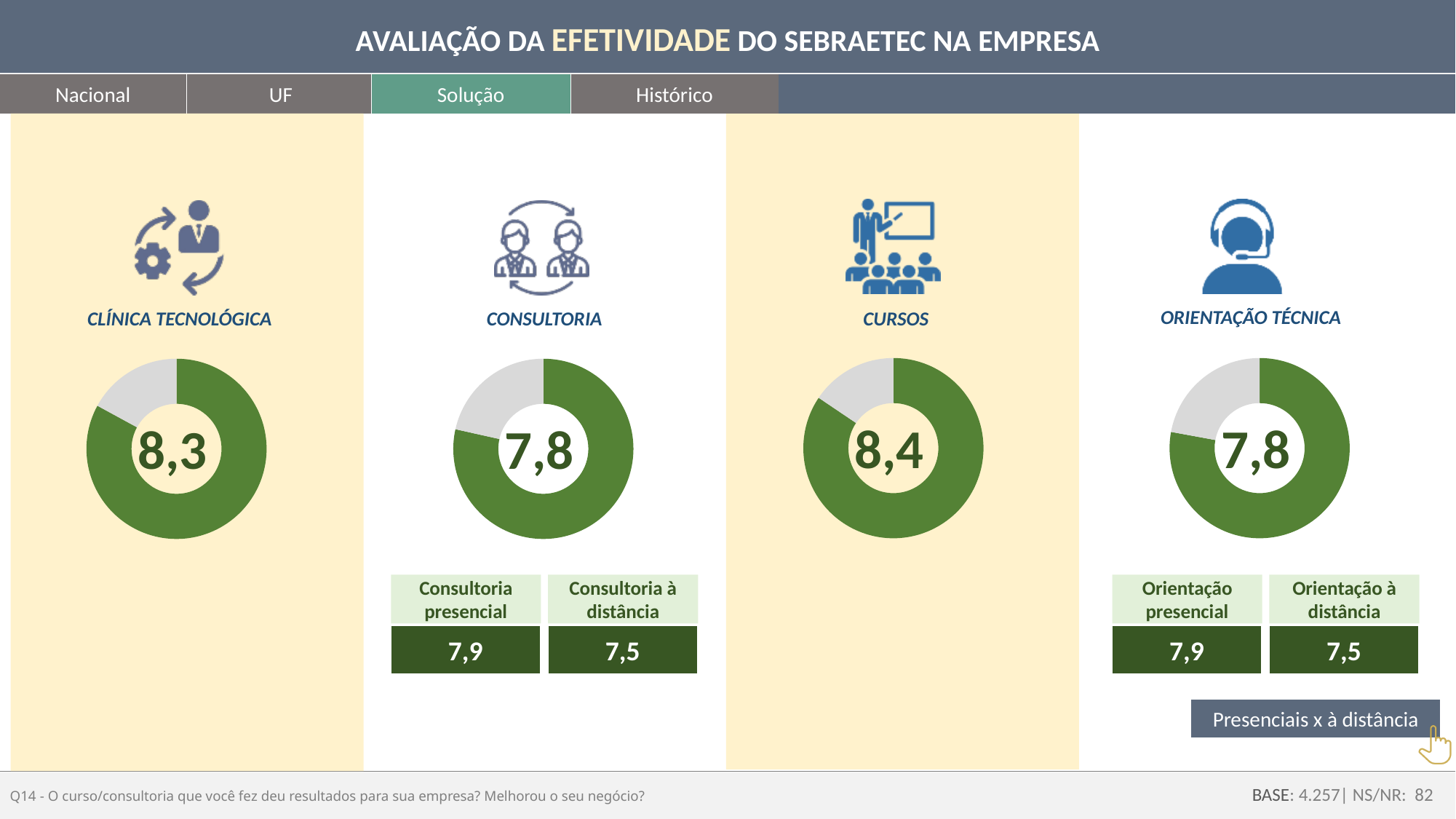
How many donut charts are shown on the slide? 4 What value is shown in the centre of the Clínica Tecnológica donut chart? 8,3 Below the Orientação Técnica chart, what value is shown for Orientação à distância? 7,5 What is the difference between the Cursos value and the Consultoria value? 0,6 Below the Consultoria chart, what value is shown for Consultoria presencial? 7,9 What value is shown in the centre of the Orientação Técnica donut chart? 7,8 What is the difference between Consultoria presencial and Consultoria à distância? 0,4 Which solution has a higher value, Clínica Tecnológica or Consultoria? Clínica Tecnológica What value is shown in the centre of the Consultoria donut chart? 7,8 What kind of chart is used to display the value for each solution? Donut chart What value is shown in the centre of the Cursos donut chart? 8,4 Which of the four donut charts shows the highest value? Cursos